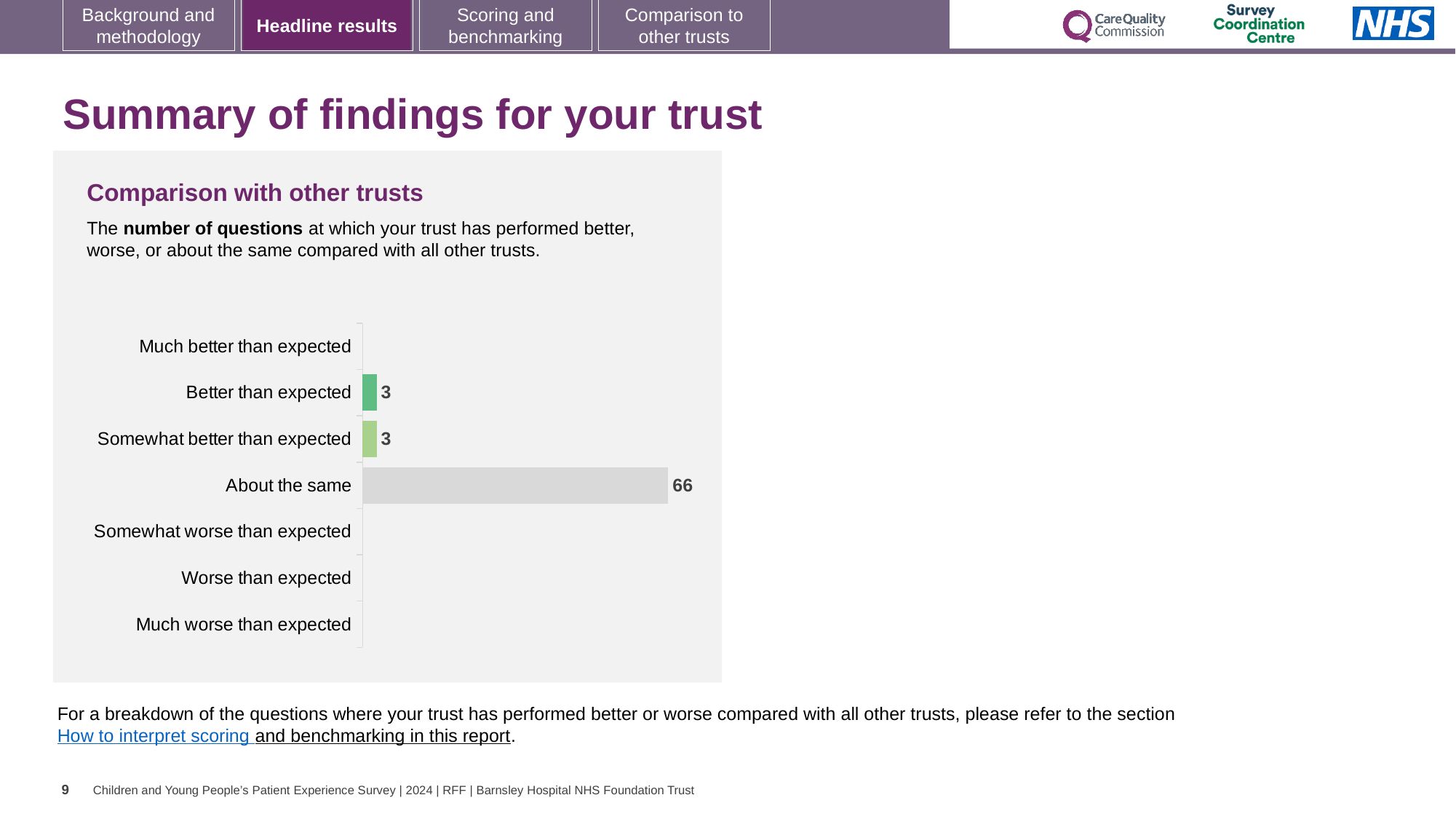
What colour is the bar for 'About the same'? Grey What is the value for 'Somewhat better than expected'? 3 What is the difference between the number of questions 'About the same' and 'Better than expected'? 63 What is the title of the chart section? Comparison with other trusts Which is larger: the value for 'About the same' or the value for 'Somewhat better than expected'? About the same What is the total number of questions across 'Better than expected', 'Somewhat better than expected' and 'About the same'? 72 What is the value for 'Better than expected'? 3 Which category has the highest number of questions? About the same How many questions are in the 'About the same' category? 66 What kind of chart is shown on the slide? Bar chart How many categories are listed on the chart's axis? 7